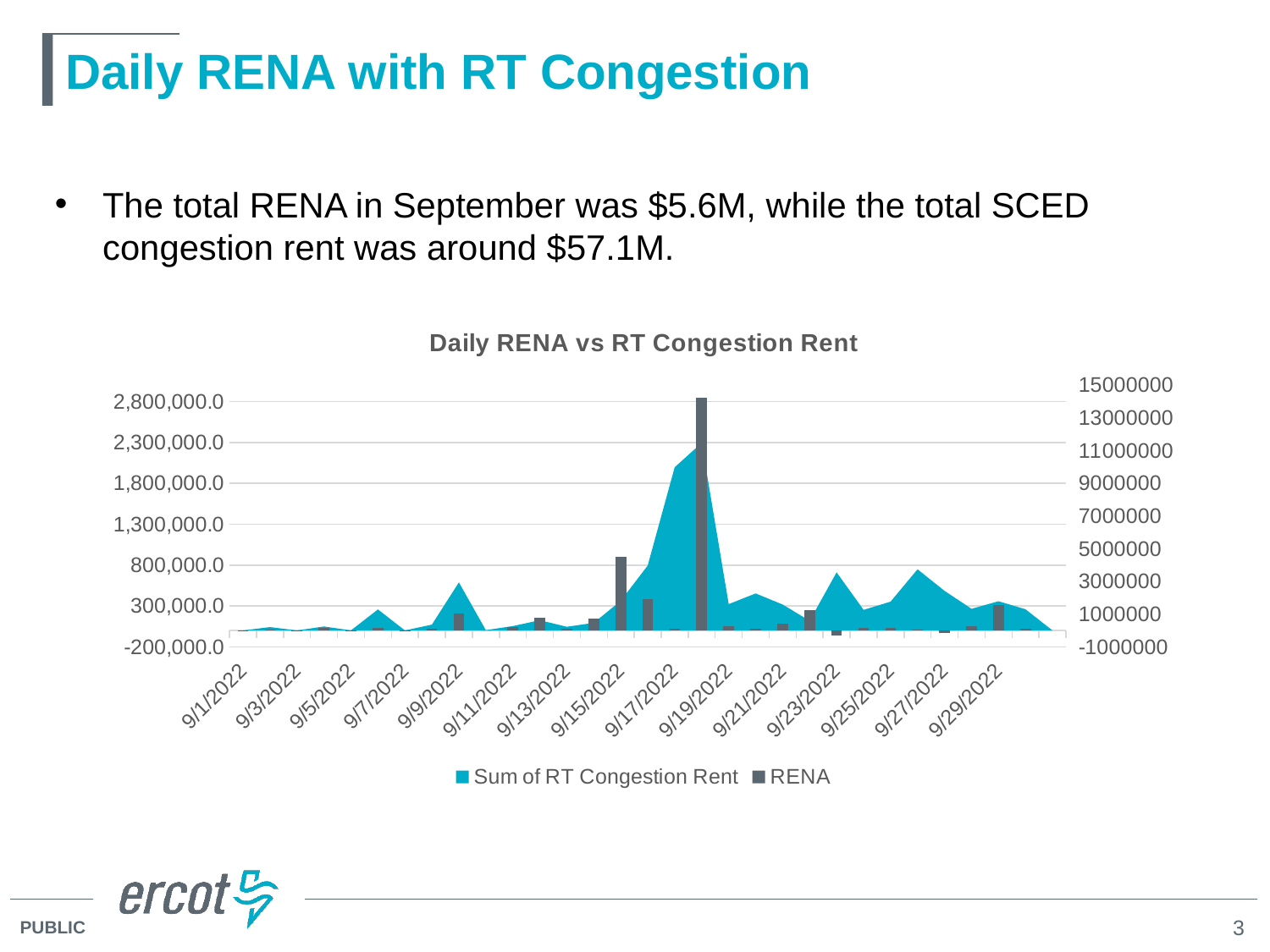
Does the Sum of RT Congestion Rent rise or fall between 9/18/2022 and 9/20/2022? fall Which is larger, the RENA value on 9/18/2022 or the RENA value on 9/1/2022? 9/18/2022 Is the tallest RENA bar greater or less than the 2,300,000.0 gridline on the left axis? greater On which date does the Sum of RT Congestion Rent series reach its peak? 9/18/2022 On which date does the RENA series reach its highest value? 9/18/2022 What is the highest value labelled on the right vertical axis? 15000000 How many date labels are shown along the x axis? 15 What are the two series named in the legend? Sum of RT Congestion Rent and RENA What is the title of the chart? Daily RENA vs RT Congestion Rent How many series does the chart legend list? 2 What is the highest value labelled on the left vertical axis? 2,800,000.0 What kind of chart is shown on the slide? A combination chart with an area series and a bar series